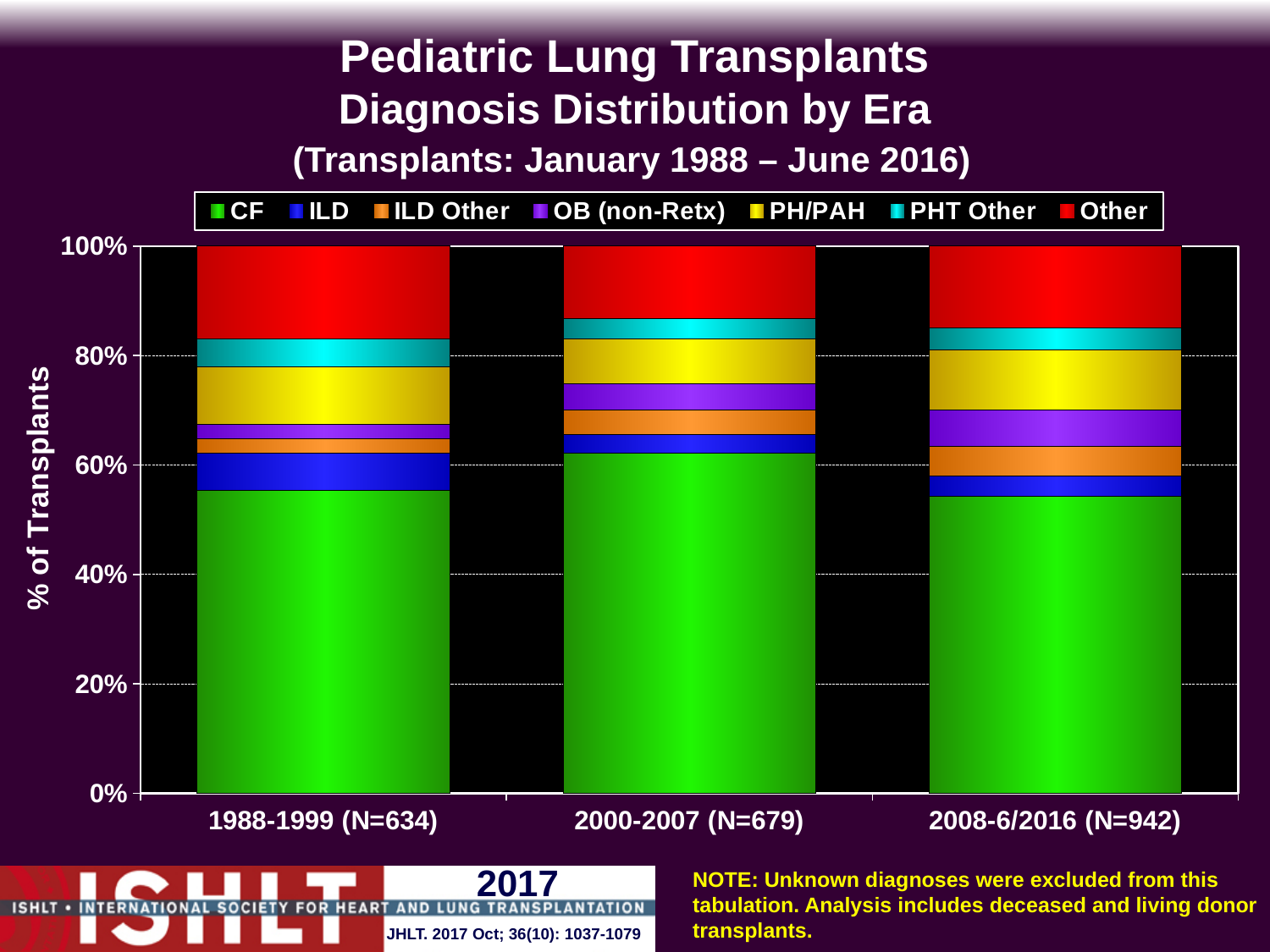
Which diagnosis is shown in green in the legend? CF What kind of chart is shown on the slide? Stacked bar chart Which era has the largest CF share of transplants? 2000-2007 (N=679) What does each stacked bar total? 100% What is the title of the chart? Pediatric Lung Transplants Diagnosis Distribution by Era How many eras (categories) are shown on the x axis? 3 How many diagnosis series does the legend list? 7 Is the CF share for 1988-1999 greater or less than 60%? less What is the N value printed for the 1988-1999 era? 634 Is the CF share for 2008-6/2016 greater or less than 60%? less What is the N value printed for the 2008-6/2016 era? 942 Is the OB (non-Retx) share larger in 1988-1999 or in 2008-6/2016? 2008-6/2016